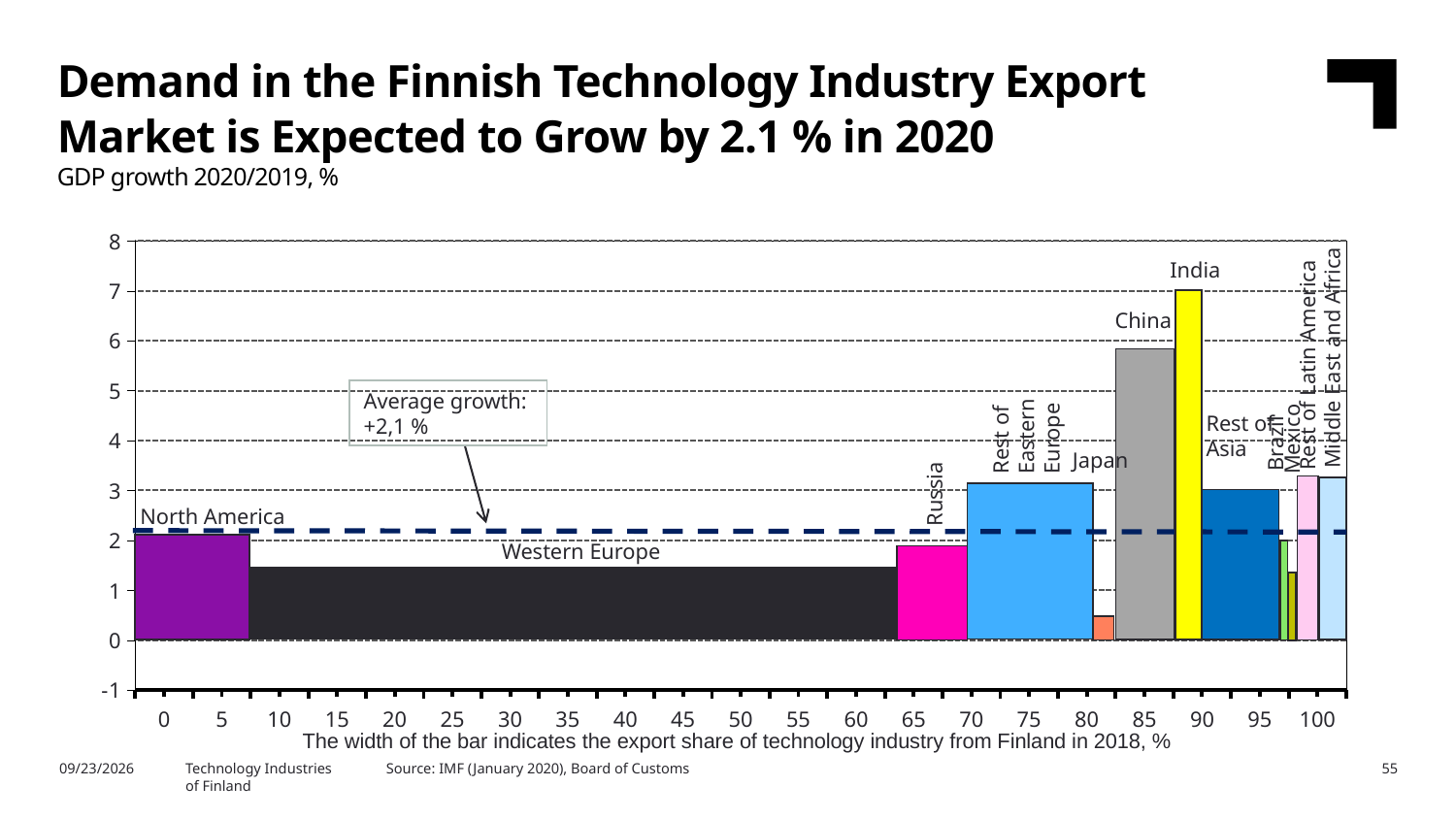
Is the GDP growth value for Rest of Asia greater or less than 2? greater Which has the higher GDP growth, China or Rest of Asia? China According to the note under the x axis, what does the width of each bar indicate? The export share of technology industry from Finland in 2018 Which region has the highest GDP growth in the chart? India Is the GDP growth value for Western Europe greater or less than 2? less How many regions are shown as bars in the chart? 12 What kind of chart is shown on the slide? Bar chart Is the GDP growth value for China greater or less than 5? greater What average growth value is shown in the chart's annotation box? +2,1 % Which region has the lowest GDP growth in the chart? Japan Which has the higher GDP growth, Western Europe or Russia? Russia